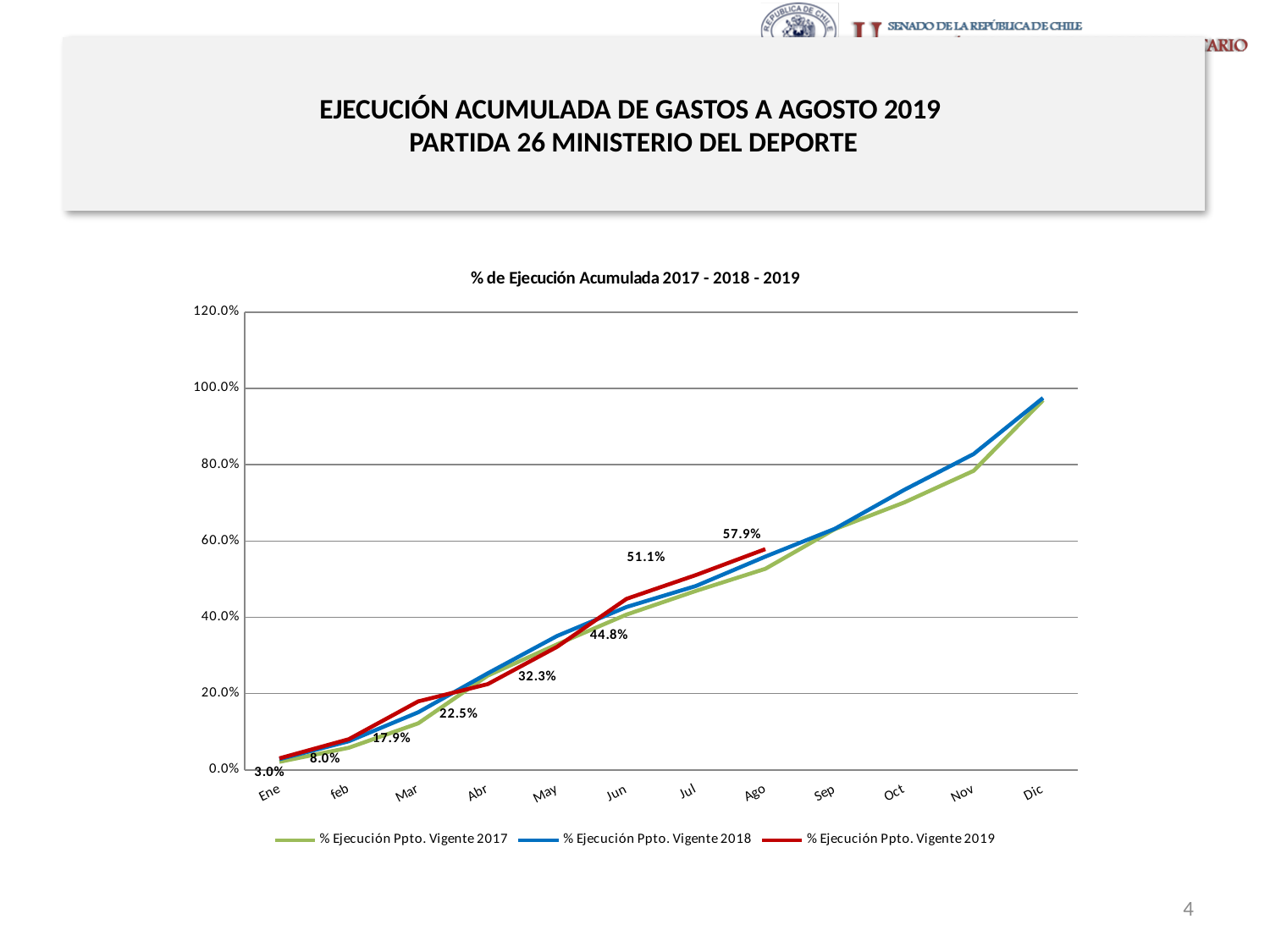
What is the title of the chart? % de Ejecución Acumulada 2017 - 2018 - 2019 Is the value of % Ejecución Ppto. Vigente 2018 in Dic greater or less than 80.0%? greater Does the % Ejecución Ppto. Vigente 2019 line rise or fall from Ene to Ago? rise What is the value of % Ejecución Ppto. Vigente 2019 in Jun? 44.8% What kind of chart is shown on the slide? line chart Which colour is used for the % Ejecución Ppto. Vigente 2019 series? red What is the value of % Ejecución Ppto. Vigente 2019 in Ago? 57.9% What is the difference between the 2019 values for Ago and Jul? 6.8% How many series does the legend list? 3 What is the value of % Ejecución Ppto. Vigente 2019 in Ene? 3.0% How many months are shown on the x axis? 12 What is the value of % Ejecución Ppto. Vigente 2019 in Abr? 22.5%